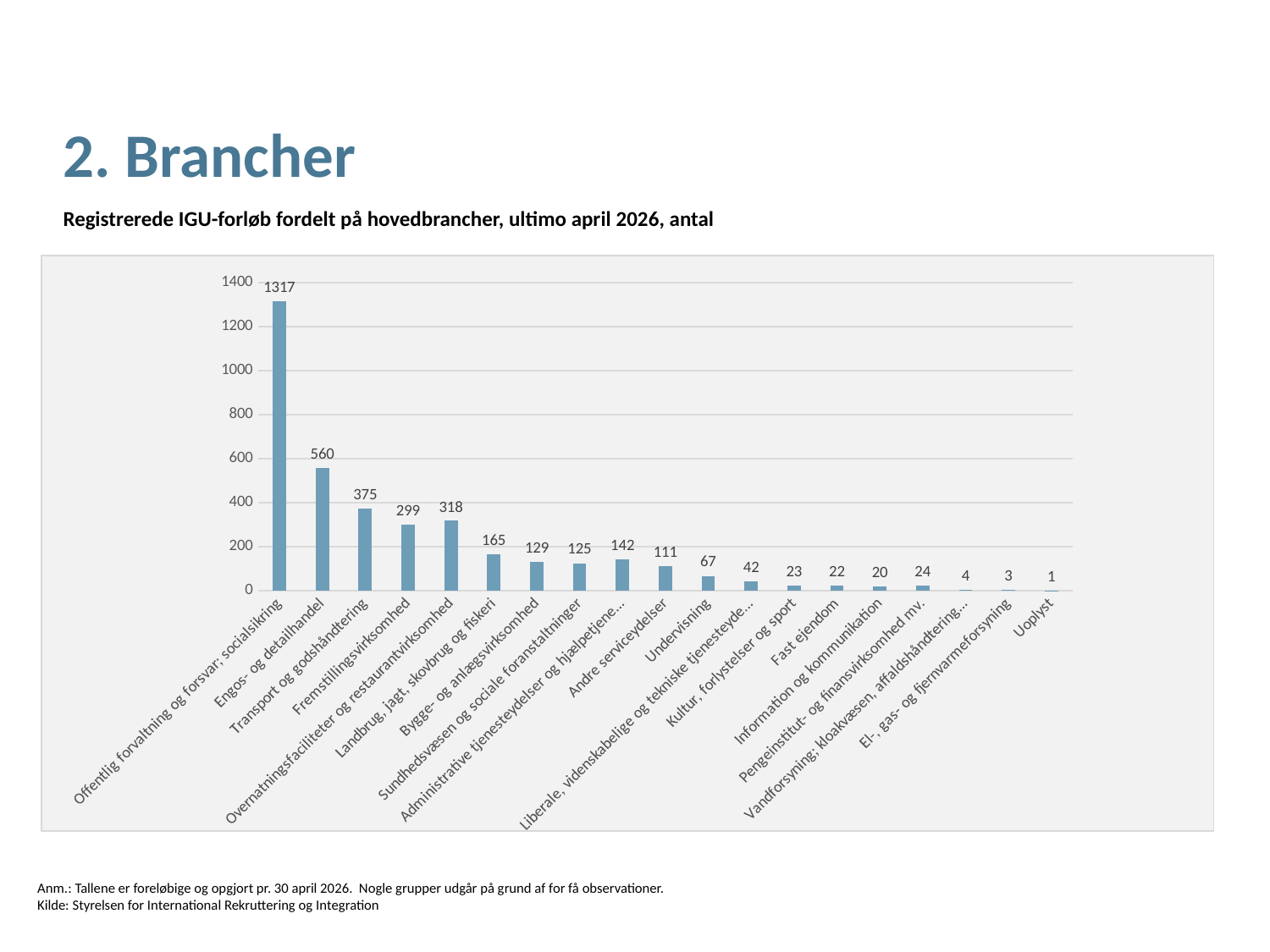
What is the value for Undervisning? 67 How many categories are shown on the x axis? 19 What kind of chart is shown on the slide? bar chart What is the value for Fremstillingsvirksomhed? 299 Which is larger, the value for Transport og godshåndtering or the value for Overnatningsfaciliteter og restaurantvirksomhed? Transport og godshåndtering What is the title of the chart? Registrerede IGU-forløb fordelt på hovedbrancher, ultimo april 2026, antal What is the value for Engros- og detailhandel? 560 What is the value for Pengeinstitut- og finansvirksomhed mv.? 24 Which category has the highest value? Offentlig forvaltning og forsvar; socialsikring What is the difference between the values for Offentlig forvaltning og forsvar; socialsikring and Engros- og detailhandel? 757 Is the value for Landbrug, jagt, skovbrug og fiskeri greater or less than 200? less Which category has the lowest value? Uoplyst